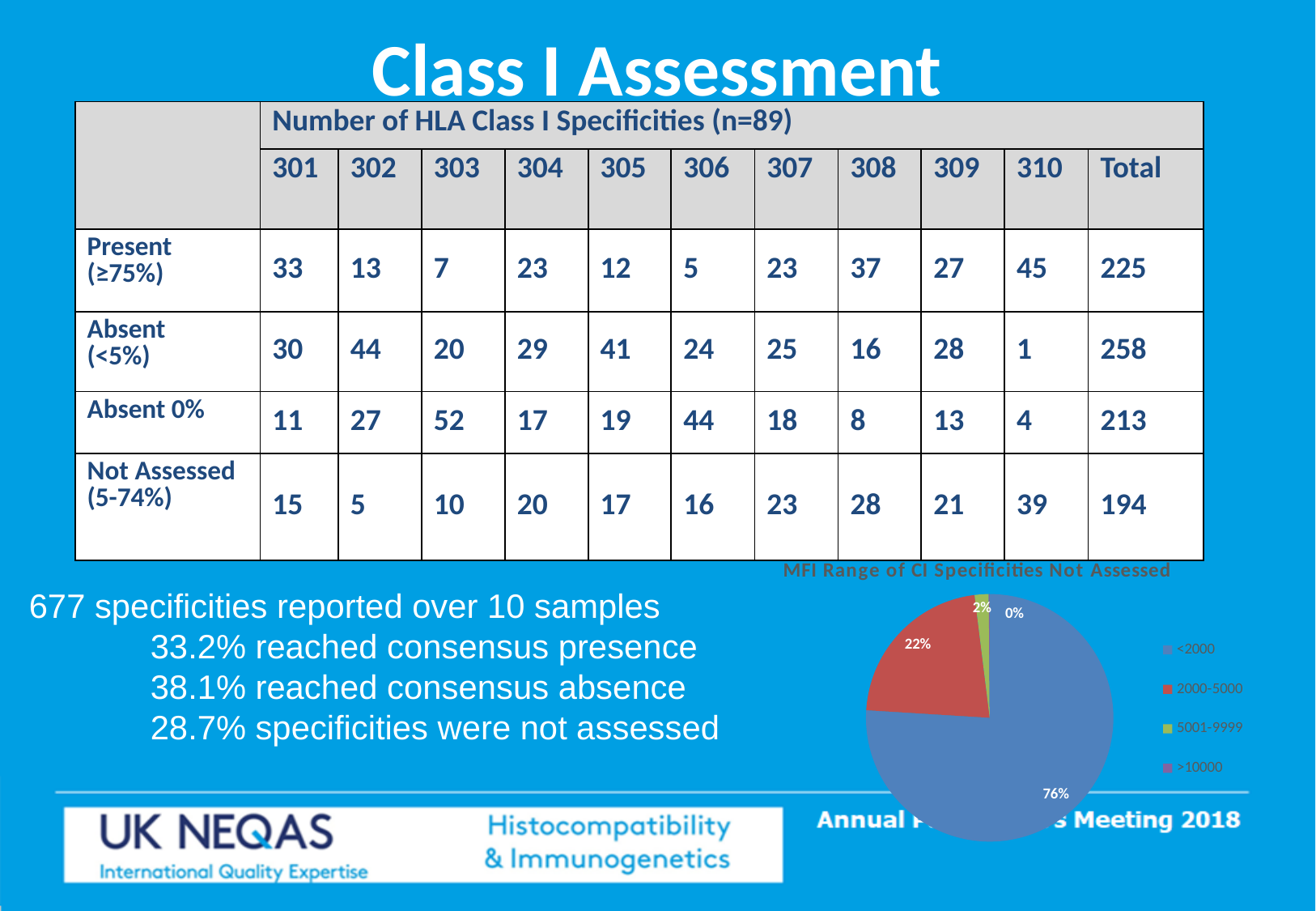
What is the difference in percentage points between the <2000 slice and the 2000-5000 slice in the pie chart? 54 Which MFI range has the largest slice in the pie chart? <2000 What share of the pie chart is the <2000 MFI range? 76% Which MFI range has the smallest slice in the pie chart? >10000 What colour is the 2000-5000 slice in the pie chart? red What share of the pie chart is the 2000-5000 MFI range? 22% What kind of chart is shown on the slide? pie chart What share of the pie chart is the >10000 MFI range? 0% What is the title of the pie chart? MFI Range of CI Specificities Not Assessed How many categories does the pie chart's legend list? 4 In the pie chart, which is larger: the <2000 slice or the 2000-5000 slice? <2000